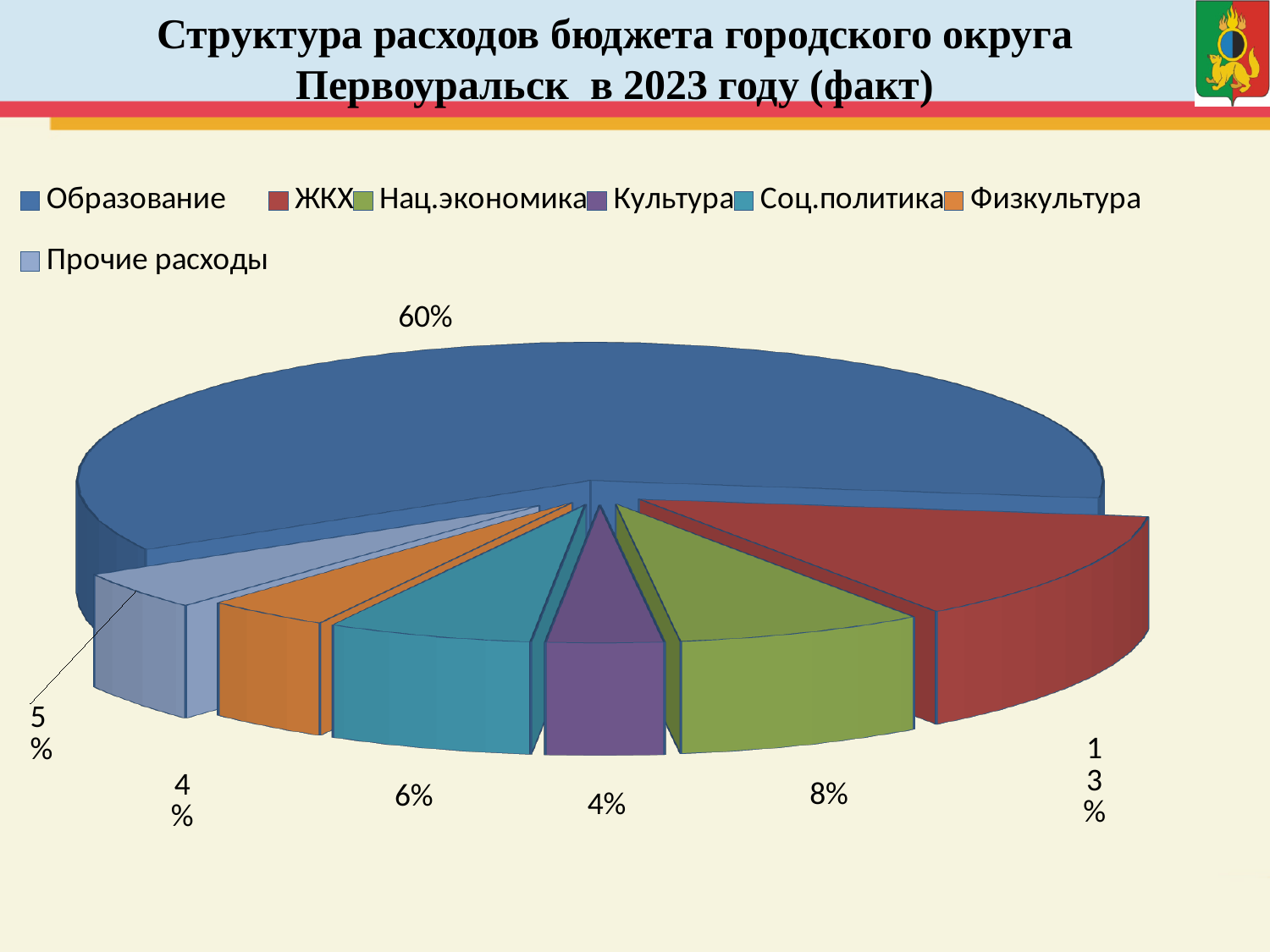
Which category has the largest share of the budget expenditure? Образование What share of the budget expenditure goes to ЖКХ? 13% How many entries does the legend list? 7 What share of the budget expenditure goes to Образование? 60% How many categories are shown in the pie chart? 7 Which colour represents Культура in the chart? purple What share of the budget expenditure goes to Нац.экономика? 8% Which has a larger share, Нац.экономика or Соц.политика? Нац.экономика What is the difference in percentage points between the shares of Образование and ЖКХ? 47 What type of chart is shown on the slide? pie chart